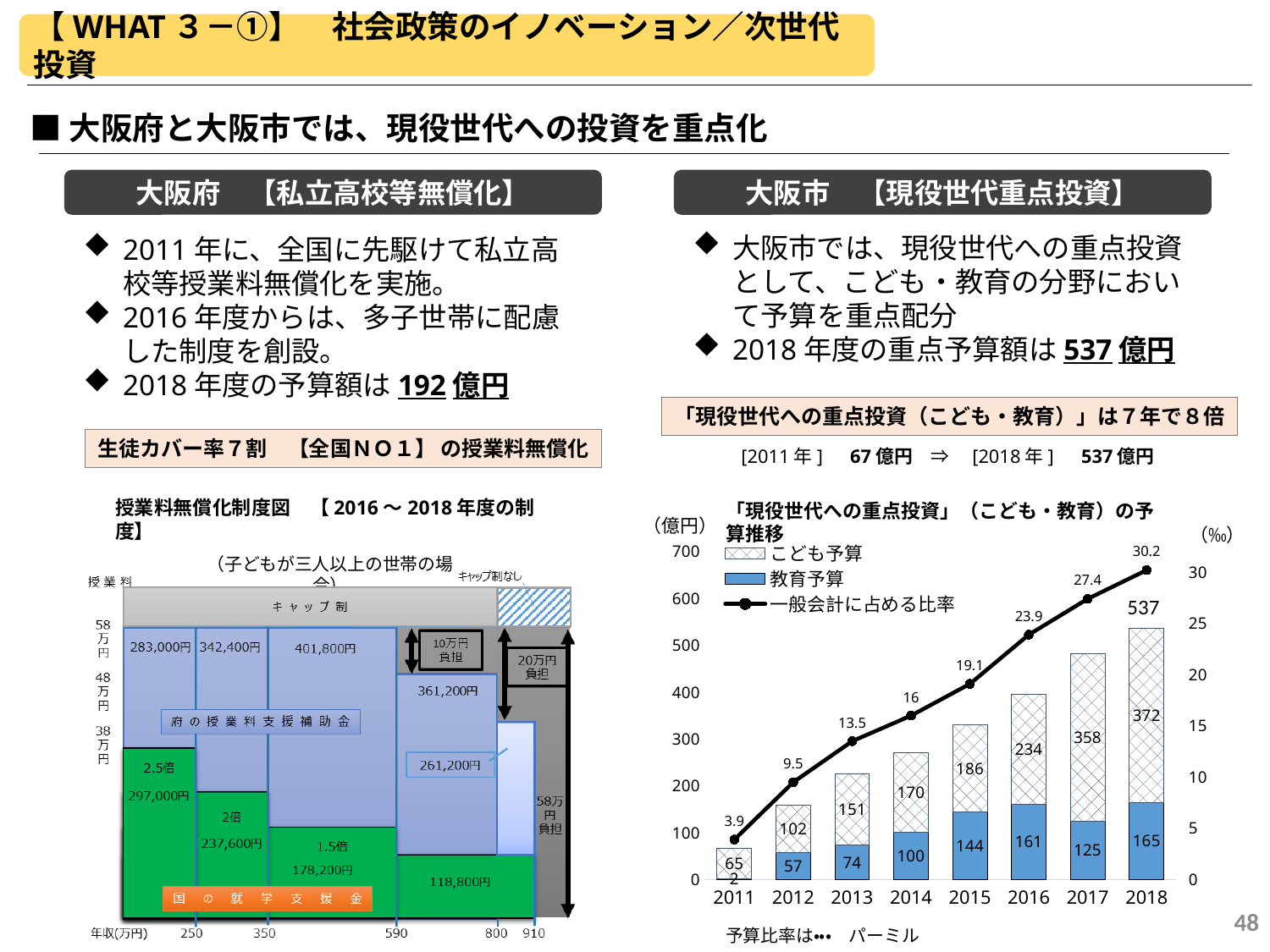
In the chart 「現役世代への重点投資」（こども・教育）の予算推移, what is the difference between こども予算 in 2018 and in 2017? 14 In the chart 「現役世代への重点投資」（こども・教育）の予算推移, which year has the lowest 教育予算? 2011 In the chart 「現役世代への重点投資」（こども・教育）の予算推移, what is the value of こども予算 for 2017? 358 In the chart 「現役世代への重点投資」（こども・教育）の予算推移, what is the value of 教育予算 for 2015? 144 In the chart 「現役世代への重点投資」（こども・教育）の予算推移, which year has the highest 一般会計に占める比率? 2018 In the chart 「現役世代への重点投資」（こども・教育）の予算推移, does the 一般会計に占める比率 line rise or fall from 2011 to 2018? Rises In the chart 「現役世代への重点投資」（こども・教育）の予算推移, what is the 一般会計に占める比率 value for 2014? 16 In the chart 「現役世代への重点投資」（こども・教育）の予算推移, which year has the larger 教育予算, 2016 or 2017? 2016 In the chart 「現役世代への重点投資」（こども・教育）の予算推移, what is the total of the stacked bar for 2018? 537 In the chart 「現役世代への重点投資」（こども・教育）の予算推移, how many years are shown on the x axis? 8 In the chart 「現役世代への重点投資」（こども・教育）の予算推移, how many series does the legend list? 3 What kind of chart is 「現役世代への重点投資」（こども・教育）の予算推移? Stacked bar chart with a line